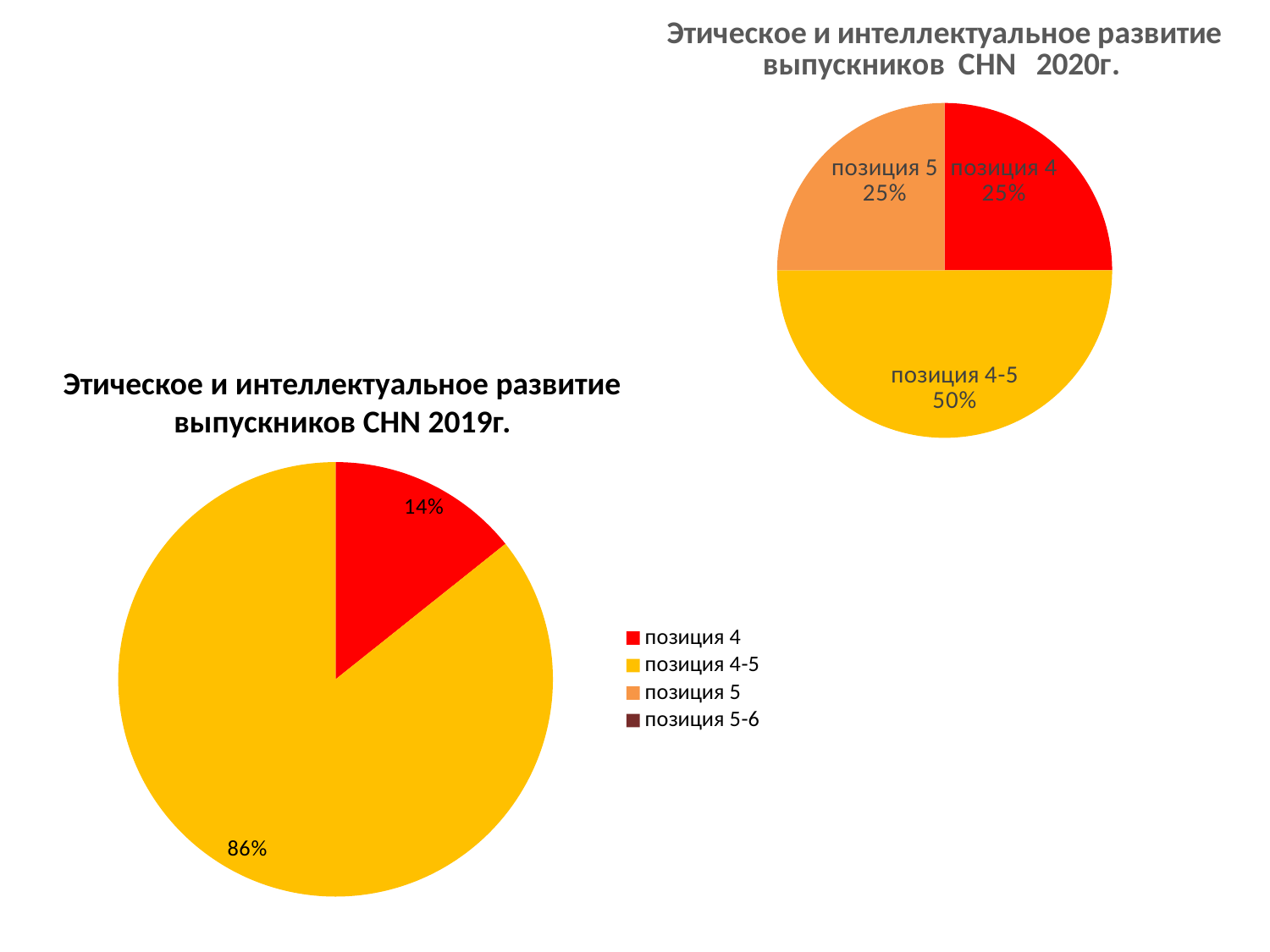
What type of chart is used for the 2019 data? Pie chart In the 2020 chart, what is the difference between the share of позиция 4-5 and the share of позиция 5? 25% In the 2020 chart, which category has the largest slice? позиция 4-5 In the 2019 chart, which category has the smallest slice? позиция 4 In the 2020 chart (Этическое и интеллектуальное развитие выпускников CHN 2020г.), what share does позиция 4-5 have? 50% How many slices are shown in the 2020 chart? 3 How many entries does the legend next to the 2019 chart list? 4 In the 2019 chart, what share does the yellow slice (позиция 4-5) have? 86% In the 2020 chart, what share does позиция 4 have? 25% In the 2020 chart, what share does позиция 5 have? 25% In the 2019 chart (Этическое и интеллектуальное развитие выпускников CHN 2019г.), what share does the red slice (позиция 4) have? 14% In the 2019 chart, what is the difference between the share of позиция 4-5 and the share of позиция 4? 72%